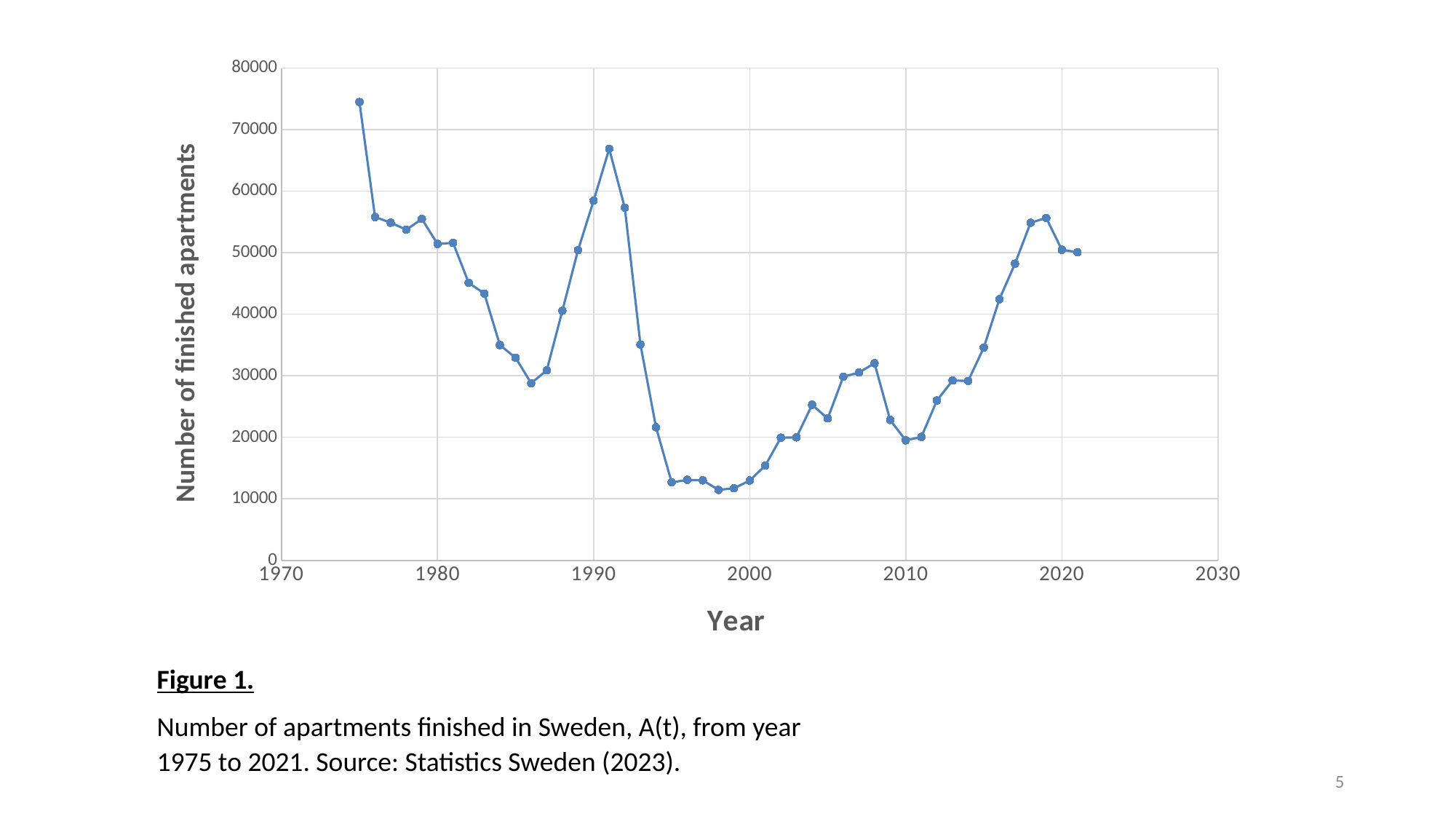
Is the value for 2019 greater or less than 50000? greater Is the value for 1998 greater or less than 20000? less Is the value for 1975 greater or less than 70000? greater Which year has the larger value, 1986 or 1995? 1986 In which year is the number of finished apartments highest? 1975 What kind of chart is shown on the slide? line chart Do the values rise or fall from 1991 to 1995? fall What is the label of the vertical axis? Number of finished apartments What is the label of the horizontal axis? Year Which year has the larger value, 1975 or 1991? 1975